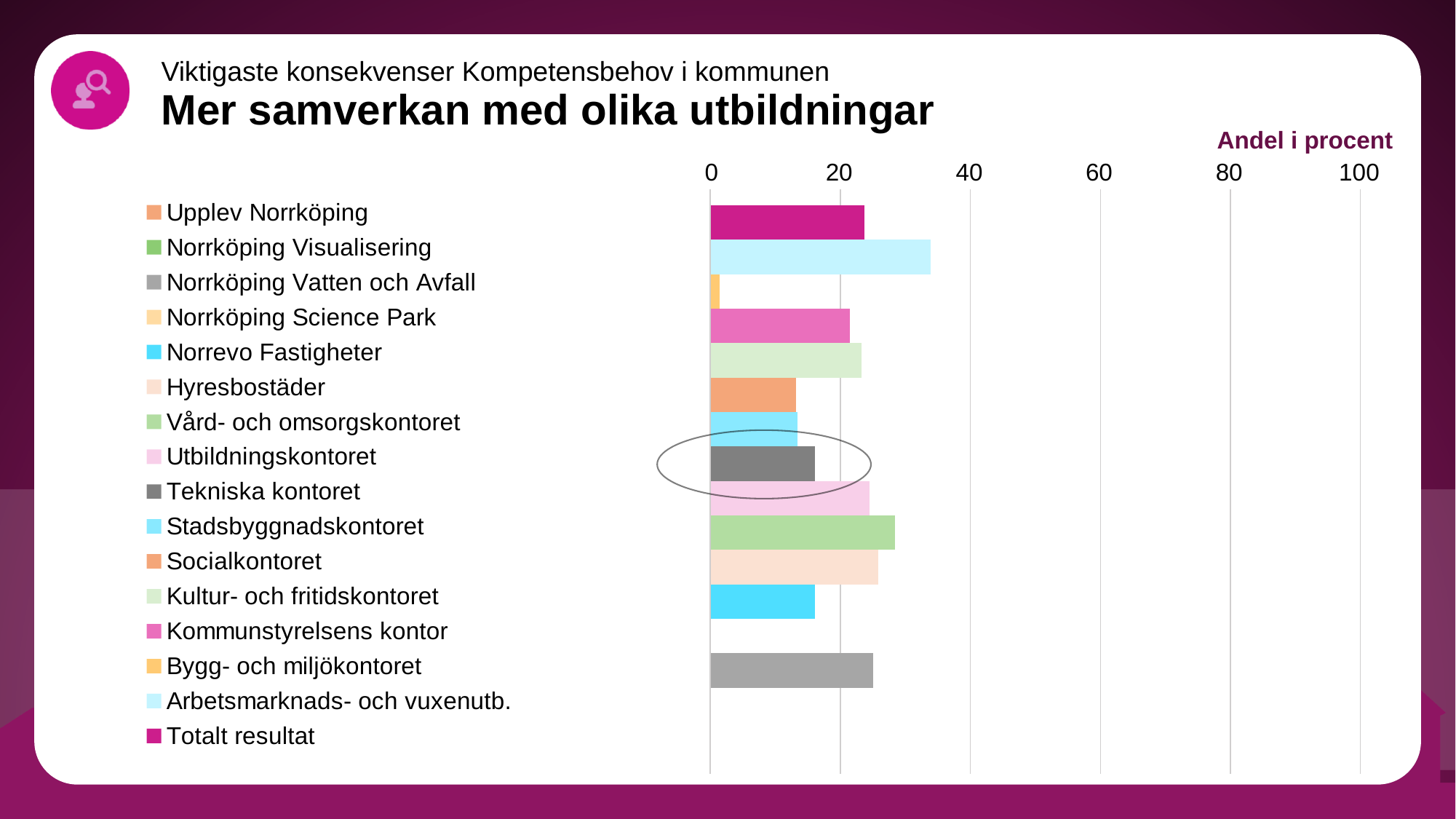
Is the value for Socialkontoret greater or less than 20? less Is the value for Vård- och omsorgskontoret greater or less than 20? greater Which series' bar is circled in the chart? Tekniska kontoret Which series has the highest value in the chart? Arbetsmarknads- och vuxenutb. Which is larger, the value for Vård- och omsorgskontoret or the value for Socialkontoret? Vård- och omsorgskontoret Which is larger, the value for Arbetsmarknads- och vuxenutb. or the value for Totalt resultat? Arbetsmarknads- och vuxenutb. What is the axis title shown above the horizontal axis of the chart? Andel i procent Is the value for Bygg- och miljökontoret greater or less than 20? less How many entries does the chart legend list? 16 What kind of chart is shown on the slide? bar chart